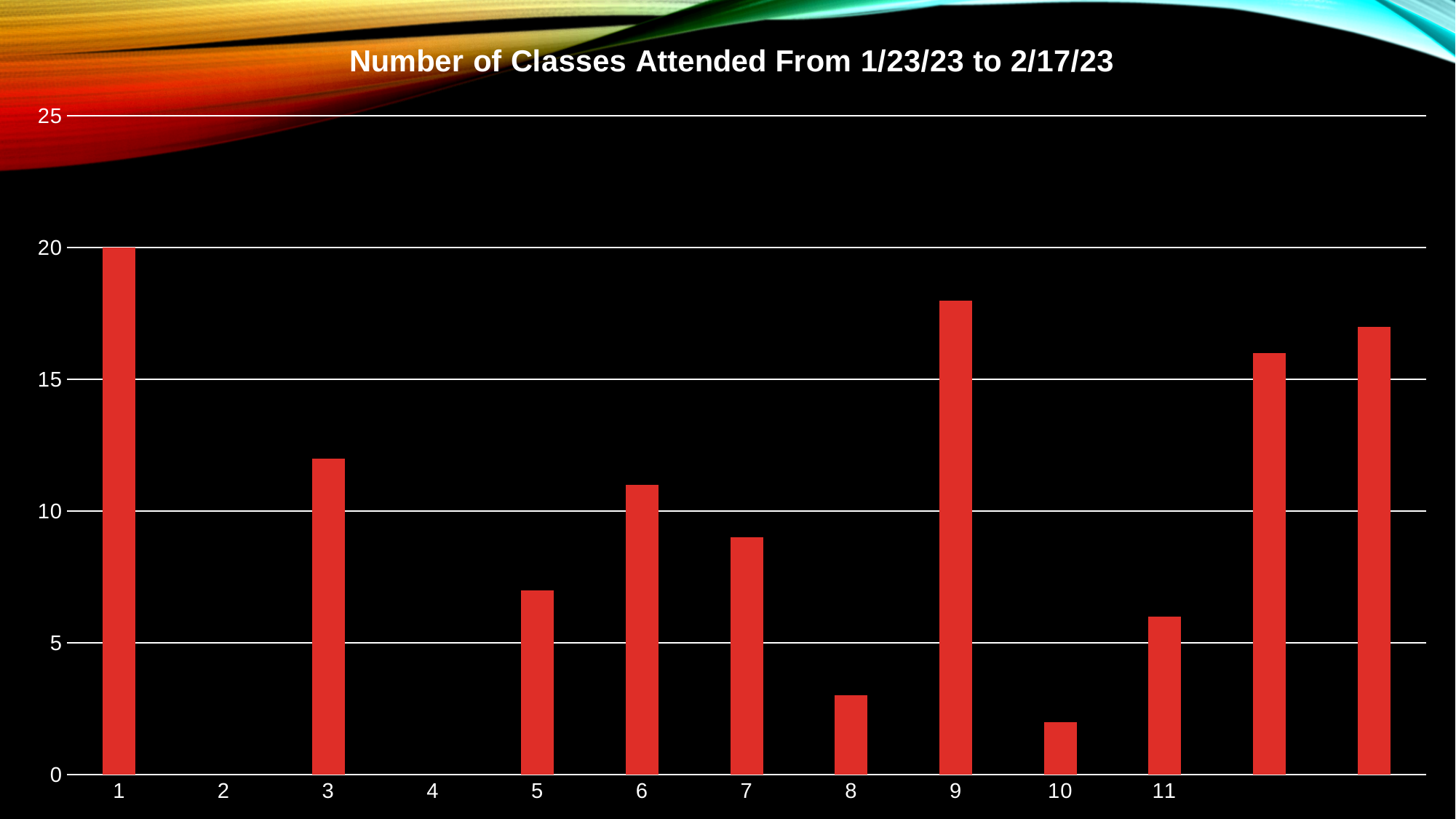
Which has the larger value, category 5 or category 7? 7 Is the value for category 3 greater or less than 10? greater Which category has the highest value? 1 What kind of chart is shown on the slide? bar chart What is the title of the chart? Number of Classes Attended From 1/23/23 to 2/17/23 What colour are the bars in the chart? red What is the value for category 1? 20 Is the value for category 9 greater or less than 15? greater Is the value for category 8 greater or less than 5? less Which has the larger value, category 9 or category 11? 9